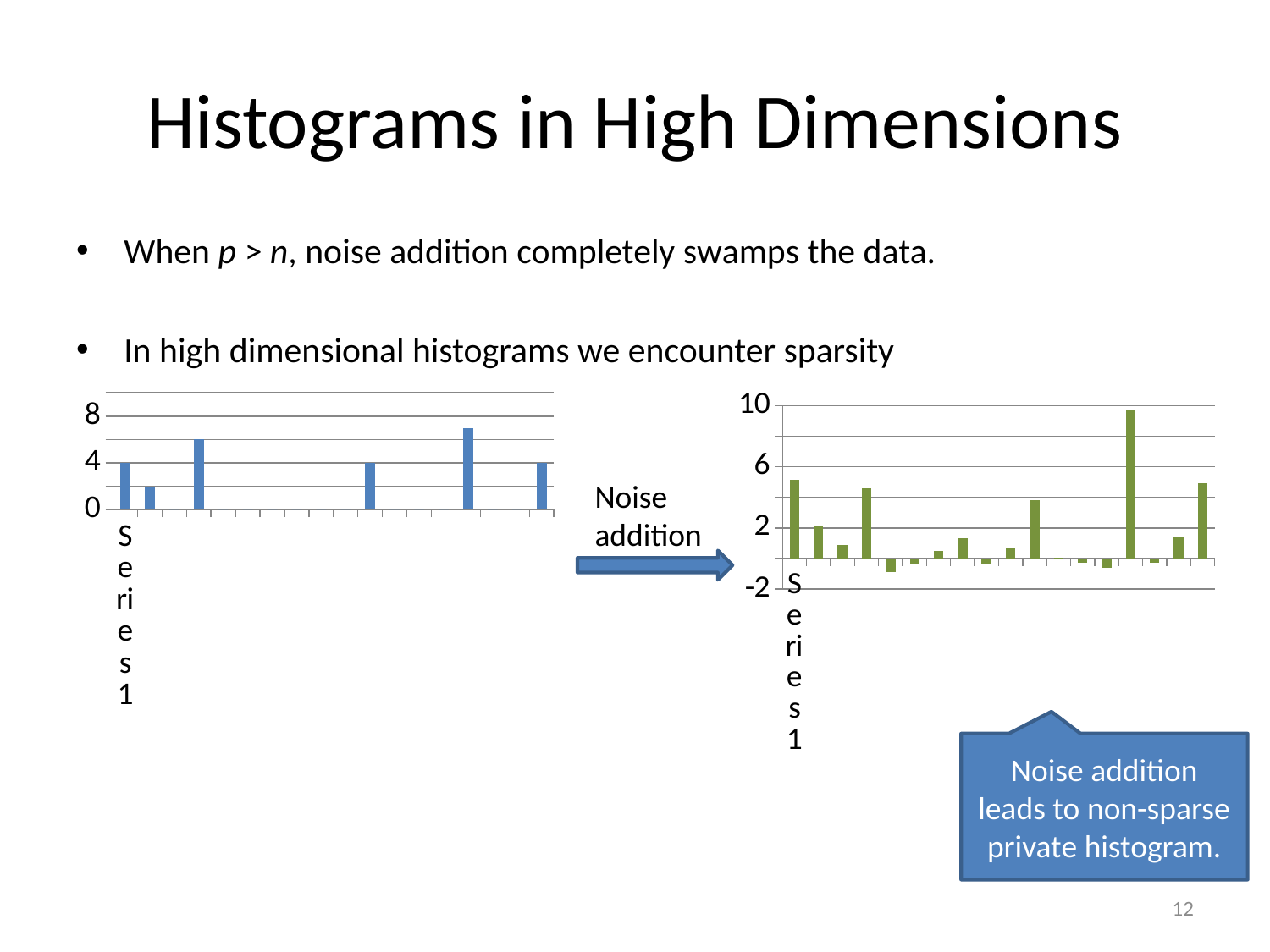
In the right chart, is the tallest bar greater or less than 6? greater What kind of chart is the chart on the right of the slide? bar chart What is the name of the series shown in the left chart? Series 1 What colour are the bars in the right chart? green In the left chart, is the tallest bar greater or less than 8? less What kind of chart is the chart on the left of the slide? bar chart What is the lowest value shown on the y axis of the right chart? -2 How many non-zero bars are plotted in the left chart? 6 In the left chart, is the tallest bar greater or less than 4? greater